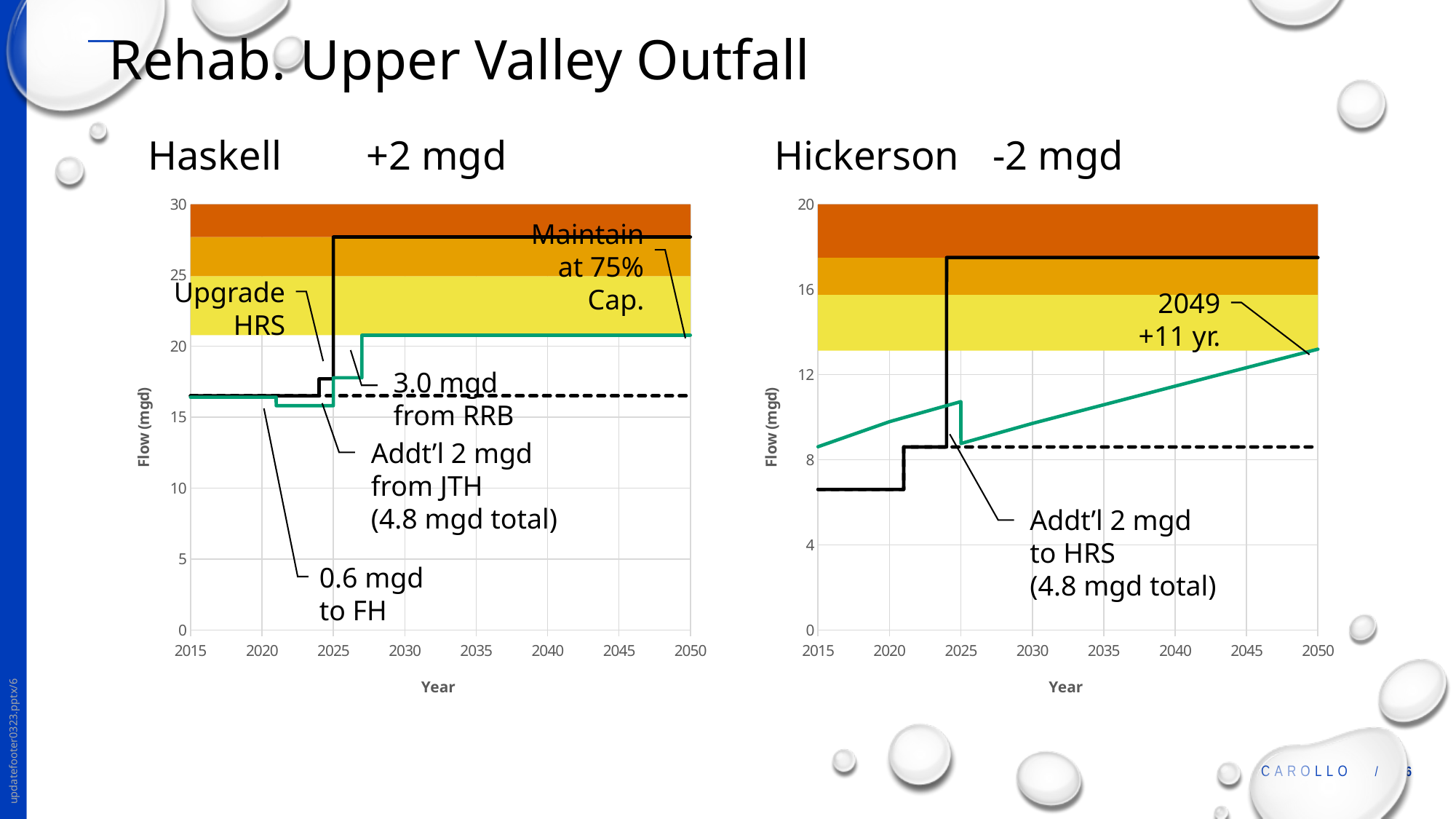
On the Hickerson chart, is the value of the green solid line at 2050 greater or less than 12? greater On the Hickerson chart, is the value of the black solid line at 2015 greater or less than 8? less On the Haskell chart, is the value of the green solid line at 2050 greater or less than 20? greater On the Haskell chart, what is the label of the y-axis? Flow (mgd) On the Haskell chart, which of the two solid lines is higher at 2040, the black line or the green line? the black line On the Hickerson chart, does the green solid line rise or fall between 2025 and 2050? rise On the Hickerson chart, which year is called out by the annotation near the right end of the green line? 2049 On the Hickerson chart, what is the label of the x-axis? Year What kind of chart is the Haskell chart? line chart